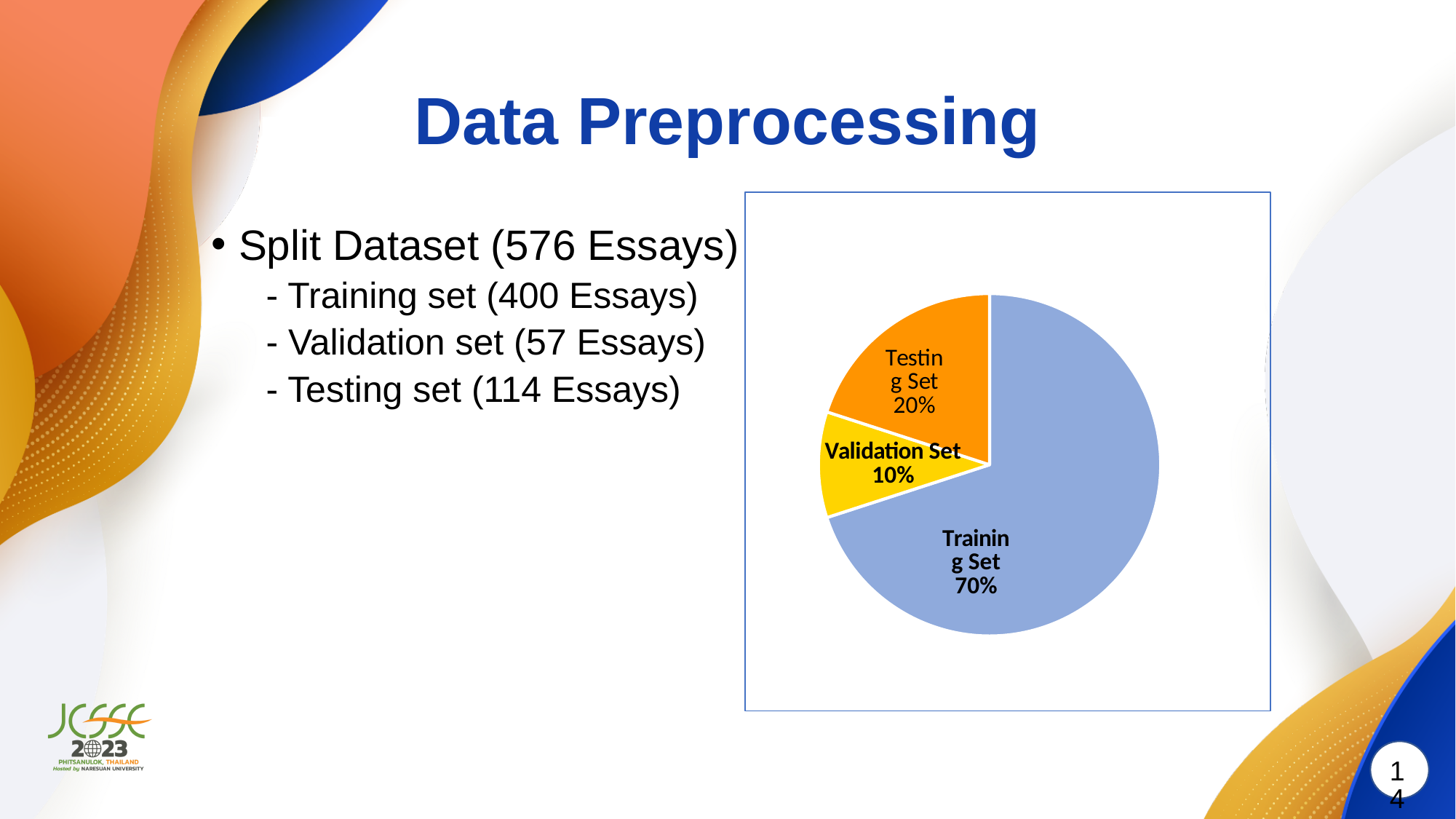
Which slice of the pie chart is the smallest? Validation Set What is the difference in percentage points between the Training Set and Testing Set slices? 50% What colour is the Training Set slice in the pie chart? blue What share of the pie does the Training Set slice represent? 70% What is the difference in percentage points between the Testing Set and Validation Set slices? 10% What share of the pie does the Validation Set slice represent? 10% Which slice of the pie chart is the largest? Training Set What share of the pie does the Testing Set slice represent? 20% What kind of chart is shown on the slide? pie chart Which is larger, the Testing Set slice or the Validation Set slice? Testing Set What colour is the Validation Set slice in the pie chart? yellow How many slices does the pie chart have? 3